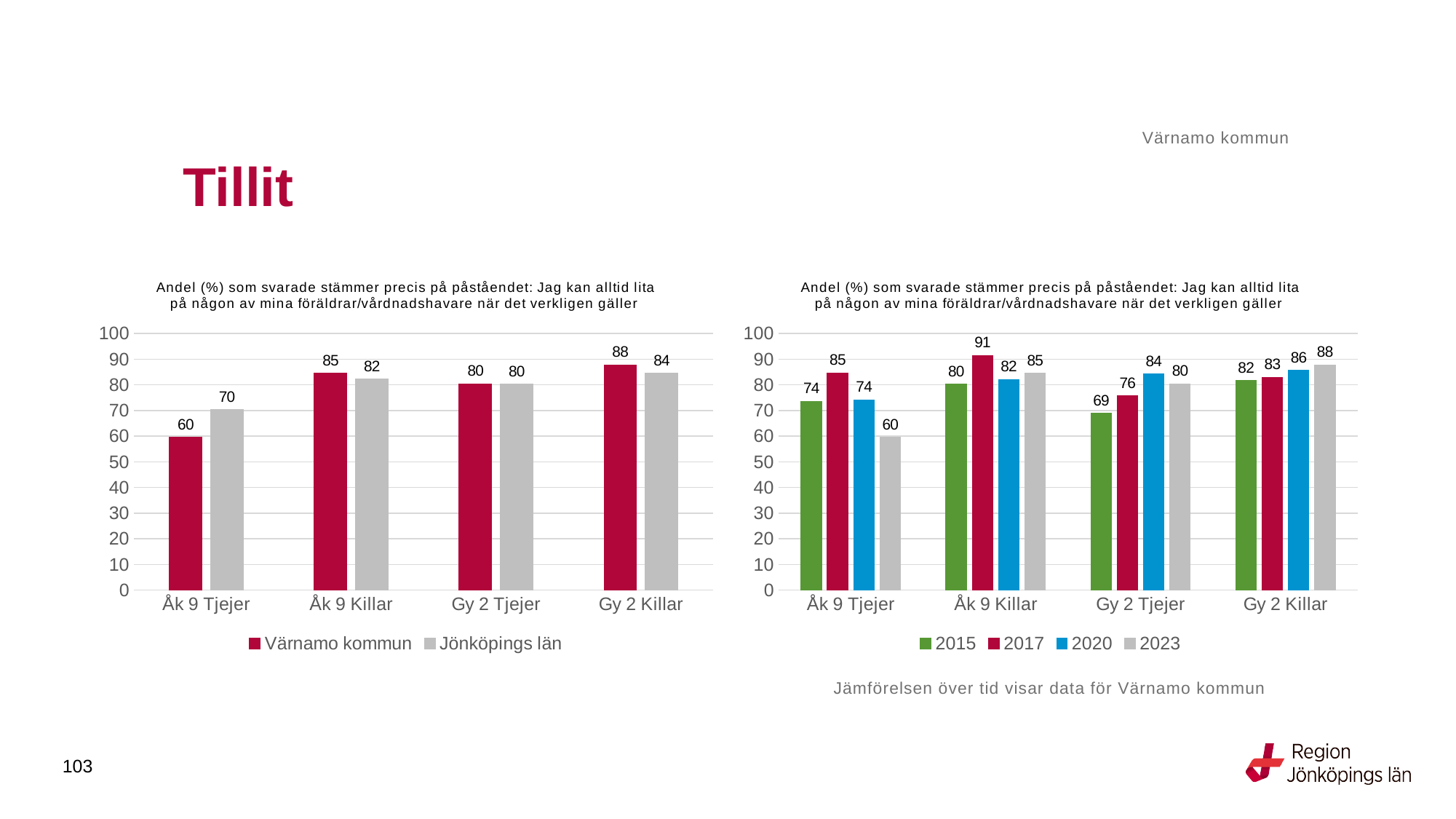
In the right chart, what is the value for 2017 for Åk 9 Killar? 91 In the left chart, what is the difference between Jönköpings län and Värnamo kommun for Åk 9 Tjejer? 10 In the right chart, which category has the lowest value for 2015? Gy 2 Tjejer In the left chart, what is the value for Värnamo kommun for Åk 9 Tjejer? 60 In the left chart, what is the value for Jönköpings län for Gy 2 Killar? 84 In the left chart, which category has the highest value for Värnamo kommun? Gy 2 Killar In the left chart, which is larger for Åk 9 Killar: Värnamo kommun or Jönköpings län? Värnamo kommun In the right chart, how many series does the legend list? 4 What kind of chart is the right chart? bar chart In the right chart, what is the value for 2023 for Åk 9 Tjejer? 60 In the right chart, do the values for Gy 2 Killar rise or fall from 2015 to 2023? rise In the left chart, how many series does the legend list? 2